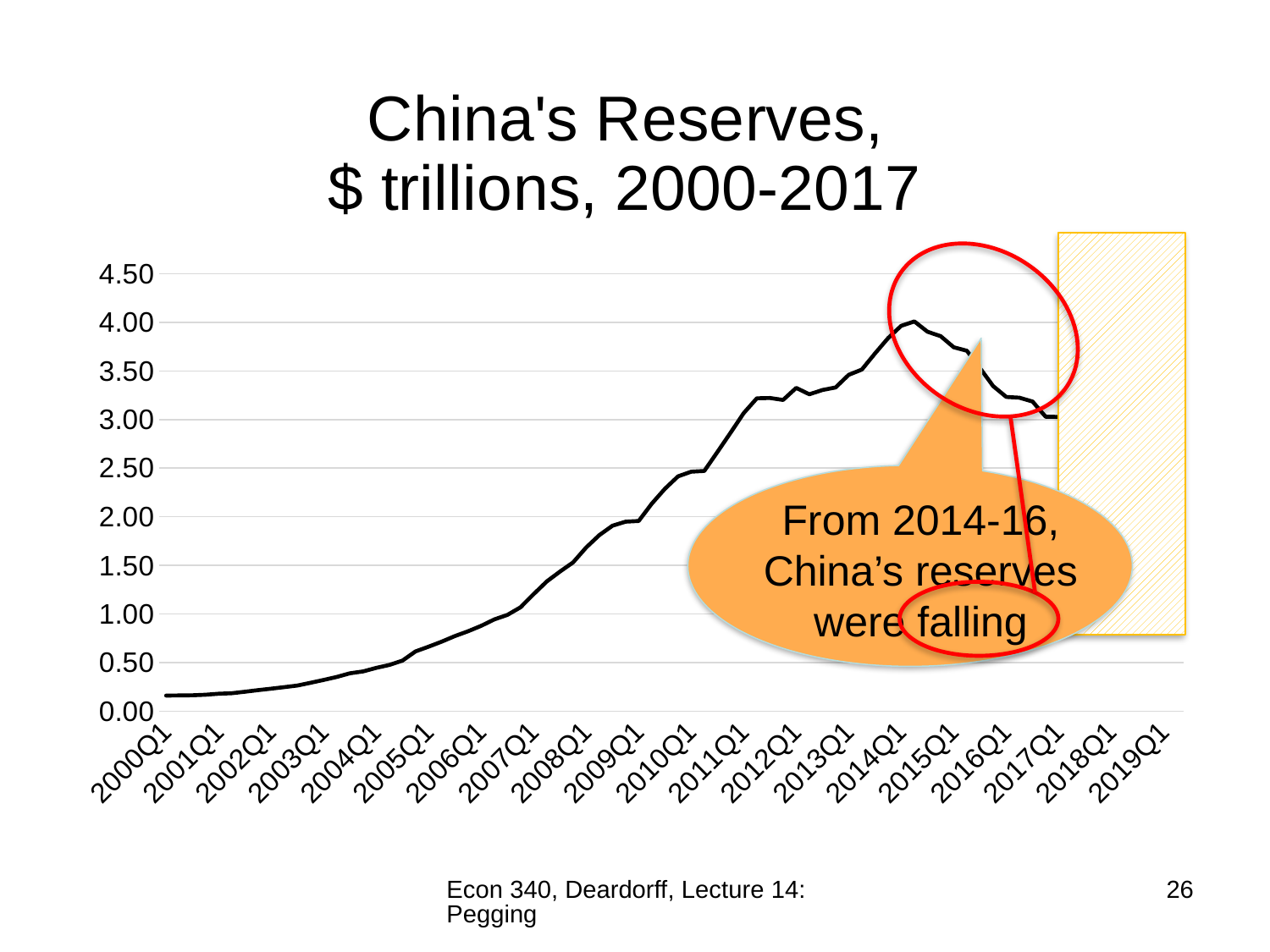
Is the value for 2000Q1 greater or less than 0.50? less How many quarter labels are shown on the x axis? 20 Is the value for 2014Q1 greater or less than 3.50? greater Do China's reserves rise or fall between 2000Q1 and 2014Q1? rise What does the callout annotation on the chart say? From 2014-16, China's reserves were falling Is the value for 2012Q1 greater or less than 3.00? greater What kind of chart is shown on the slide? line chart In which year does the line reach its highest value? 2014 Do China's reserves rise or fall between 2014Q1 and 2017Q1? fall What is the title of the chart? China's Reserves, $ trillions, 2000-2017